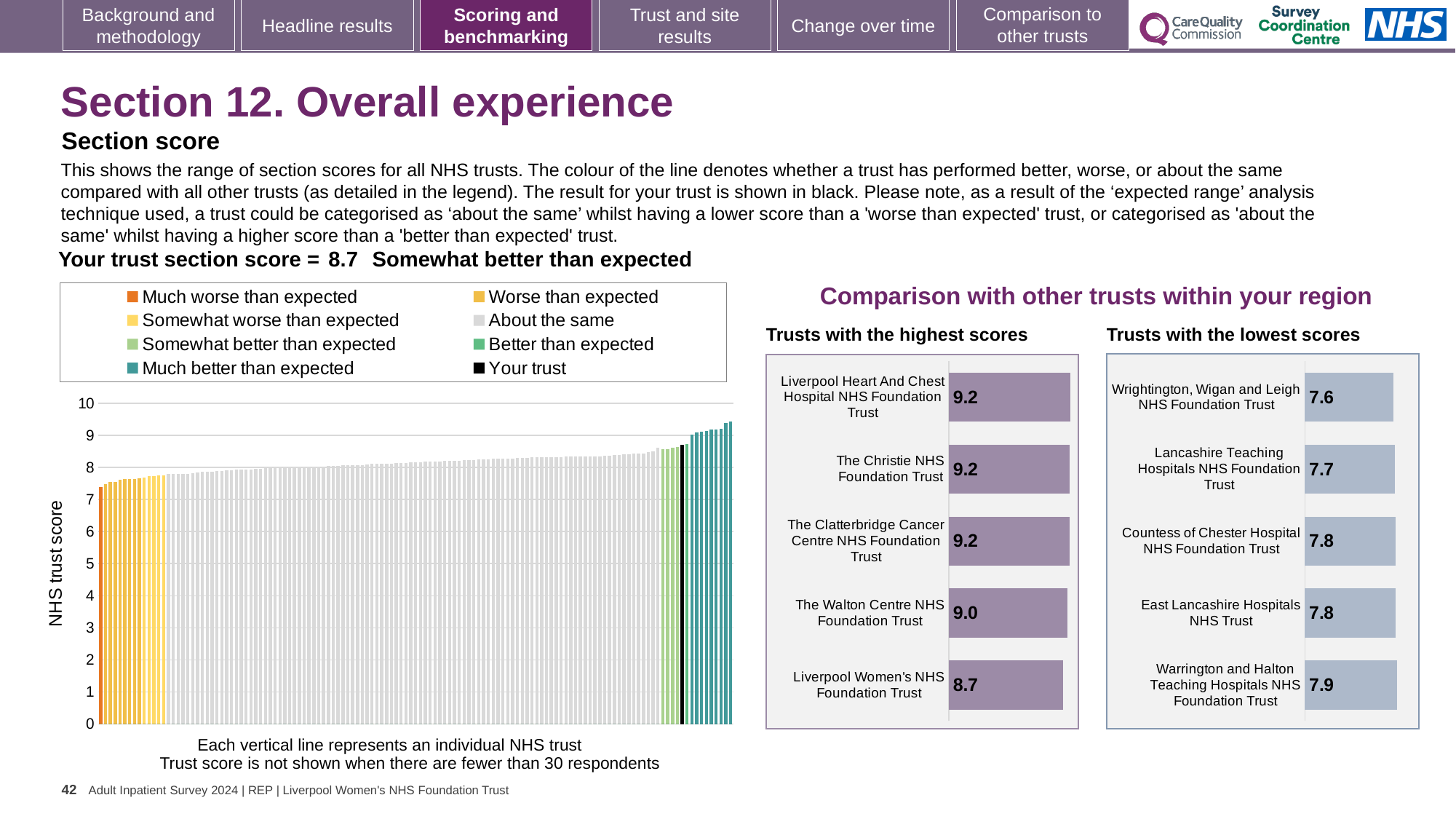
In the NHS trust score chart on the left, is the value for the black 'Your trust' bar greater or less than 8? greater In the 'Trusts with the lowest scores' chart, how much higher is the score of Warrington and Halton Teaching Hospitals NHS Foundation Trust than that of Wrightington, Wigan and Leigh NHS Foundation Trust? 0.3 What kind of chart is the NHS trust score chart on the left of the slide? Bar chart How many trusts are listed in the 'Trusts with the highest scores' chart? 5 In the 'Trusts with the highest scores' chart, what is the difference between the scores of Liverpool Heart And Chest Hospital NHS Foundation Trust and Liverpool Women's NHS Foundation Trust? 0.5 In the 'Trusts with the highest scores' chart, what is the score for The Walton Centre NHS Foundation Trust? 9.0 In the 'Trusts with the highest scores' chart, which trust has the lowest score shown? Liverpool Women's NHS Foundation Trust How many entries does the legend of the NHS trust score chart on the left list? 8 In the 'Trusts with the lowest scores' chart, which trust has the lowest score? Wrightington, Wigan and Leigh NHS Foundation Trust In the 'Trusts with the lowest scores' chart, what is the score for Wrightington, Wigan and Leigh NHS Foundation Trust? 7.6 In the NHS trust score chart on the left, do the values rise or fall from left to right? Rise In the 'Trusts with the lowest scores' chart, which has the higher score: Countess of Chester Hospital NHS Foundation Trust or Lancashire Teaching Hospitals NHS Foundation Trust? Countess of Chester Hospital NHS Foundation Trust